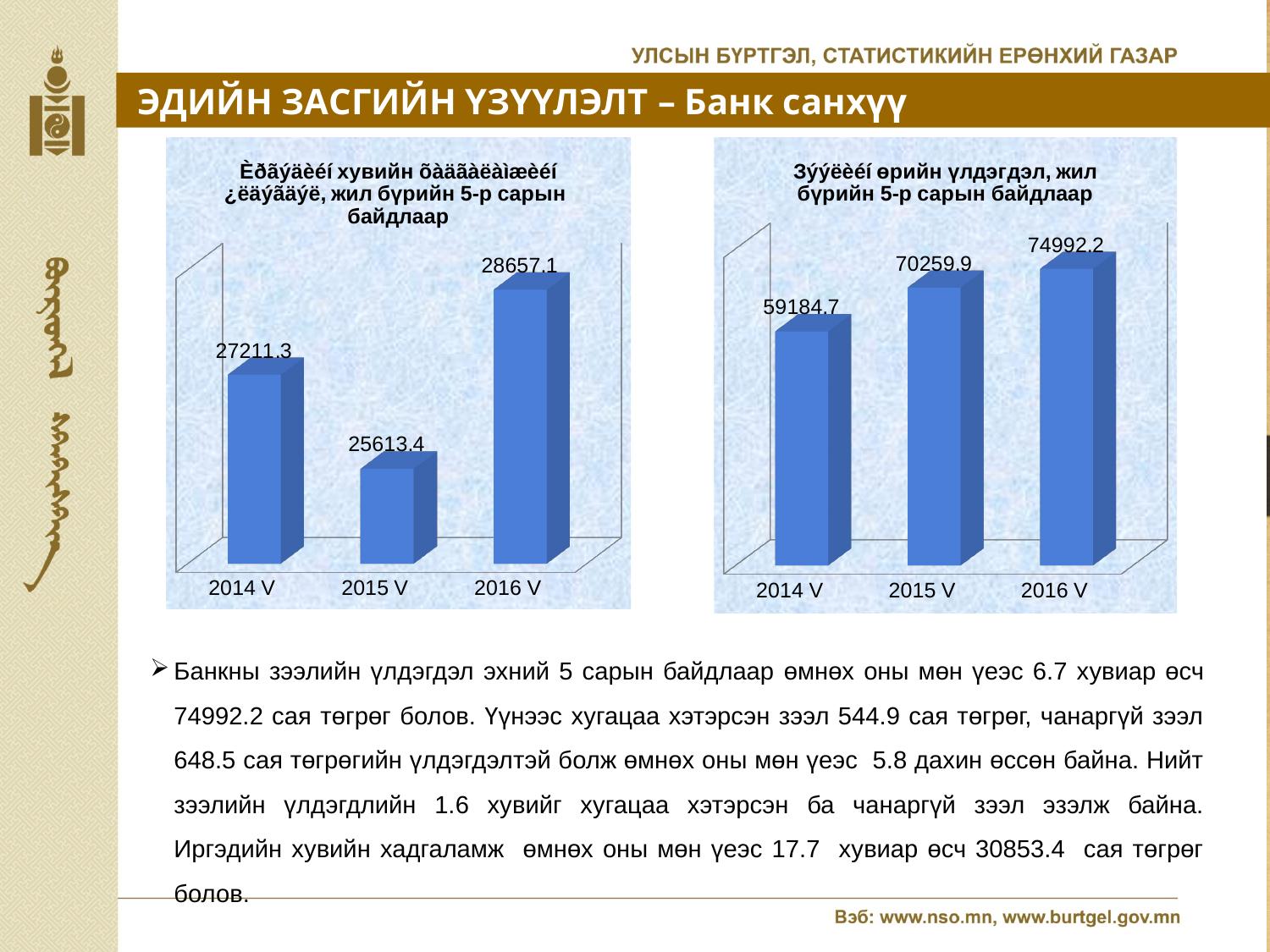
Do the values in the right chart rise or fall from 2014 V to 2016 V? rise In the left chart, which category has the lowest value? 2015 V In the right chart, which category has the lowest value? 2014 V In the left chart, what is the value for 2015 V? 25613.4 In the left chart, which category has the highest value? 2016 V In the right chart, what is the difference between the values for 2015 V and 2014 V? 11075.2 In the left chart, what is the value for 2014 V? 27211.3 In the left chart, what is the difference between the values for 2016 V and 2015 V? 3043.7 In the right chart, what is the value for 2014 V? 59184.7 In the left chart, which is larger, the value for 2014 V or the value for 2015 V? 2014 V In the right chart, what is the value for 2016 V? 74992.2 How many categories are shown in the right chart? 3